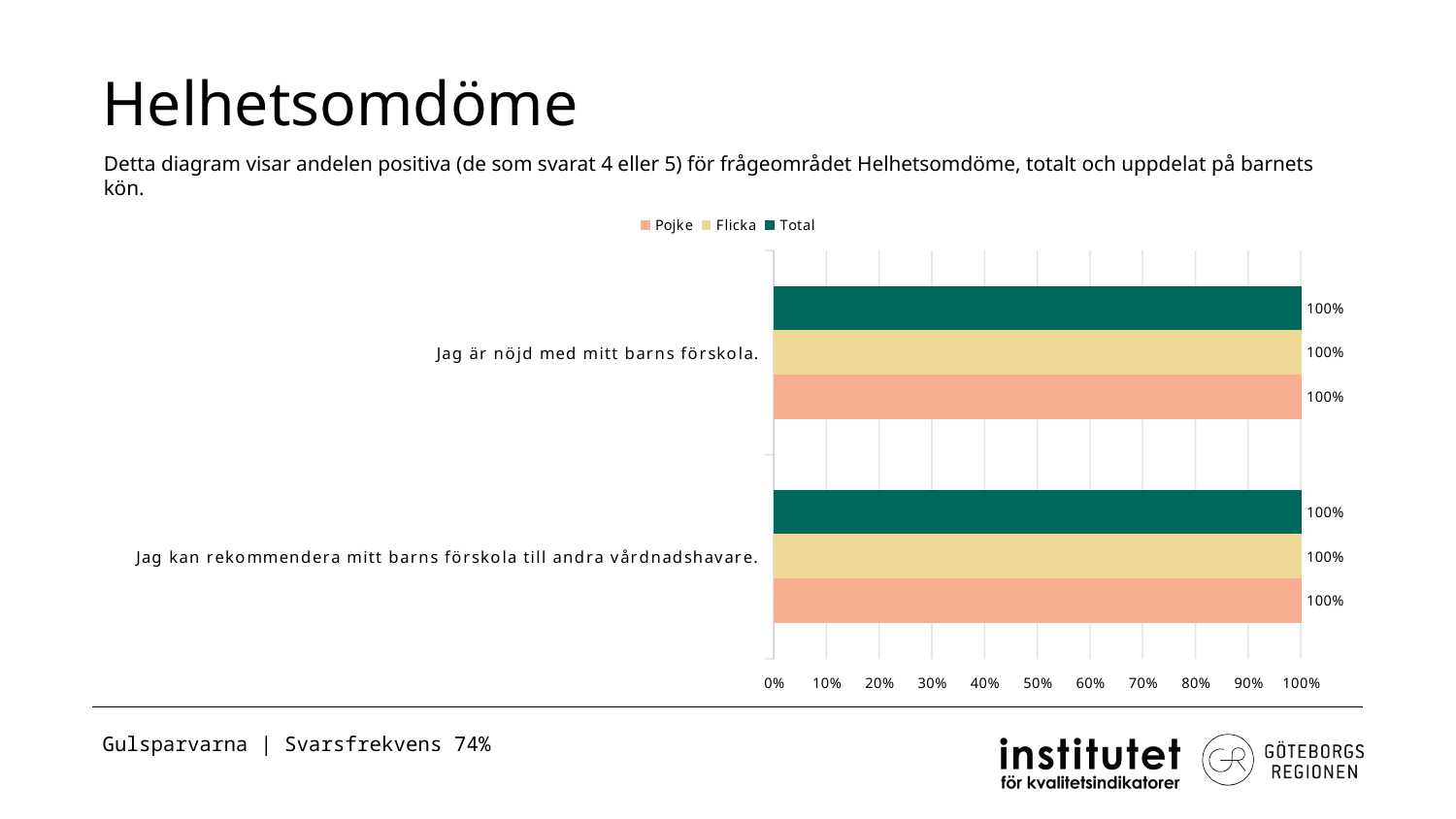
What is the highest value shown on the x axis? 100% What is the difference between the Pojke and Flicka values for "Jag är nöjd med mitt barns förskola."? 0% What kind of chart is shown on the slide? bar chart What is the value for Pojke for "Jag kan rekommendera mitt barns förskola till andra vårdnadshavare."? 100% How many series does the legend list? 3 What is the value for Flicka for "Jag kan rekommendera mitt barns förskola till andra vårdnadshavare."? 100% What is the value for Flicka for "Jag är nöjd med mitt barns förskola."? 100% How many categories (statements) are plotted on the chart? 2 Which series is listed first in the legend? Pojke What is the value for Total for "Jag är nöjd med mitt barns förskola."? 100% Which series is shown in dark green in the legend? Total Is the value for Total for "Jag kan rekommendera mitt barns förskola till andra vårdnadshavare." greater or less than 90%? greater